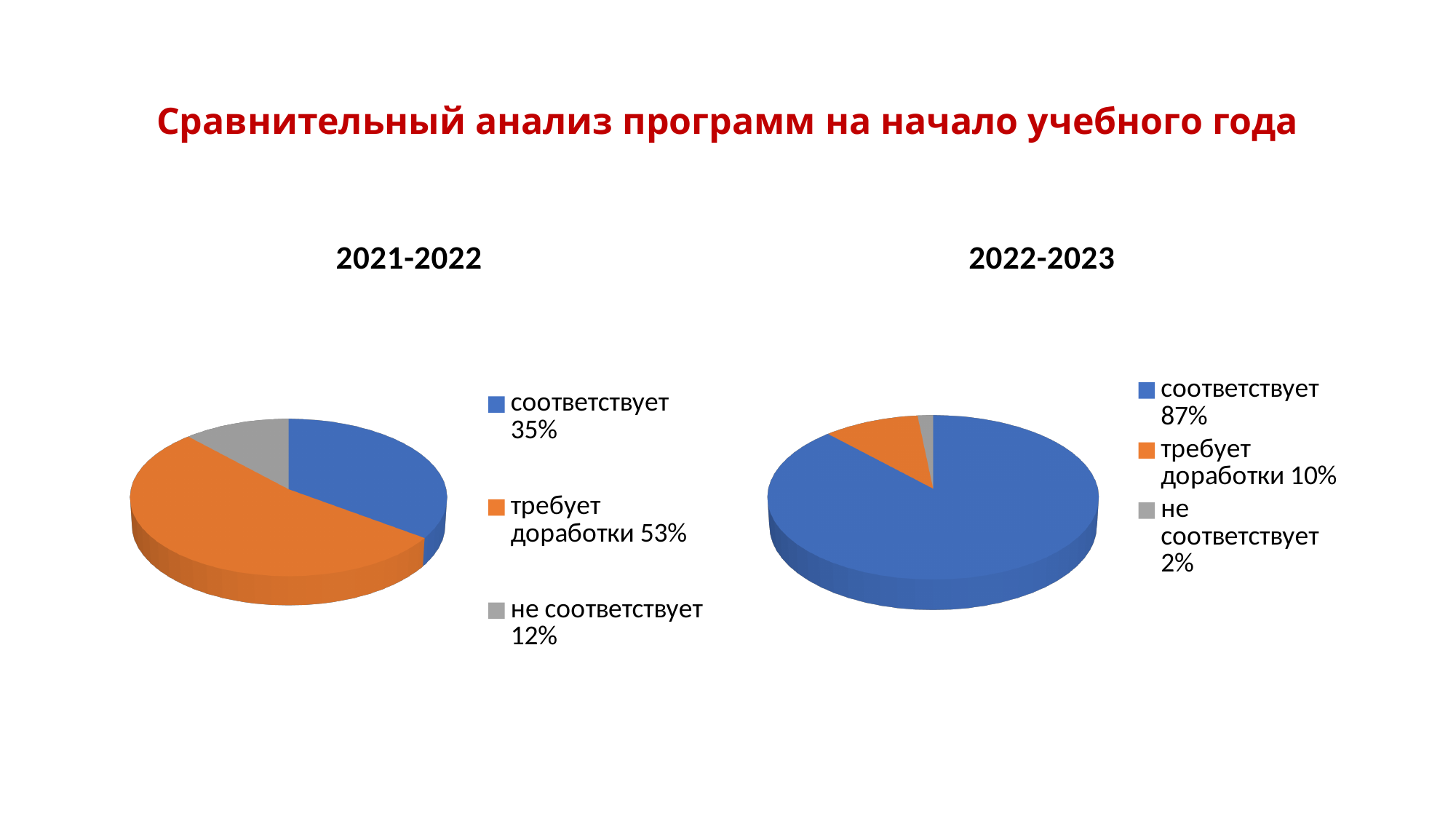
How many categories does the legend of the 2021-2022 chart list? 3 In the 2021-2022 chart, what share is labelled for "не соответствует"? 12% In the 2022-2023 chart, which category has the smallest slice? не соответствует In the 2022-2023 chart, what share is labelled for "требует доработки"? 10% In the 2021-2022 chart, which category has the largest slice? требует доработки In the 2021-2022 chart, what share is labelled for "соответствует"? 35% What is the difference between the "соответствует" share in the 2022-2023 chart and in the 2021-2022 chart? 52% In the 2022-2023 chart, what share is labelled for "не соответствует"? 2% Which is larger: "требует доработки" in the 2021-2022 chart or "требует доработки" in the 2022-2023 chart? 2021-2022 What kind of chart is the 2022-2023 chart? pie chart In the 2022-2023 chart, what share is labelled for "соответствует"? 87% In the 2021-2022 chart, what share is labelled for "требует доработки"? 53%